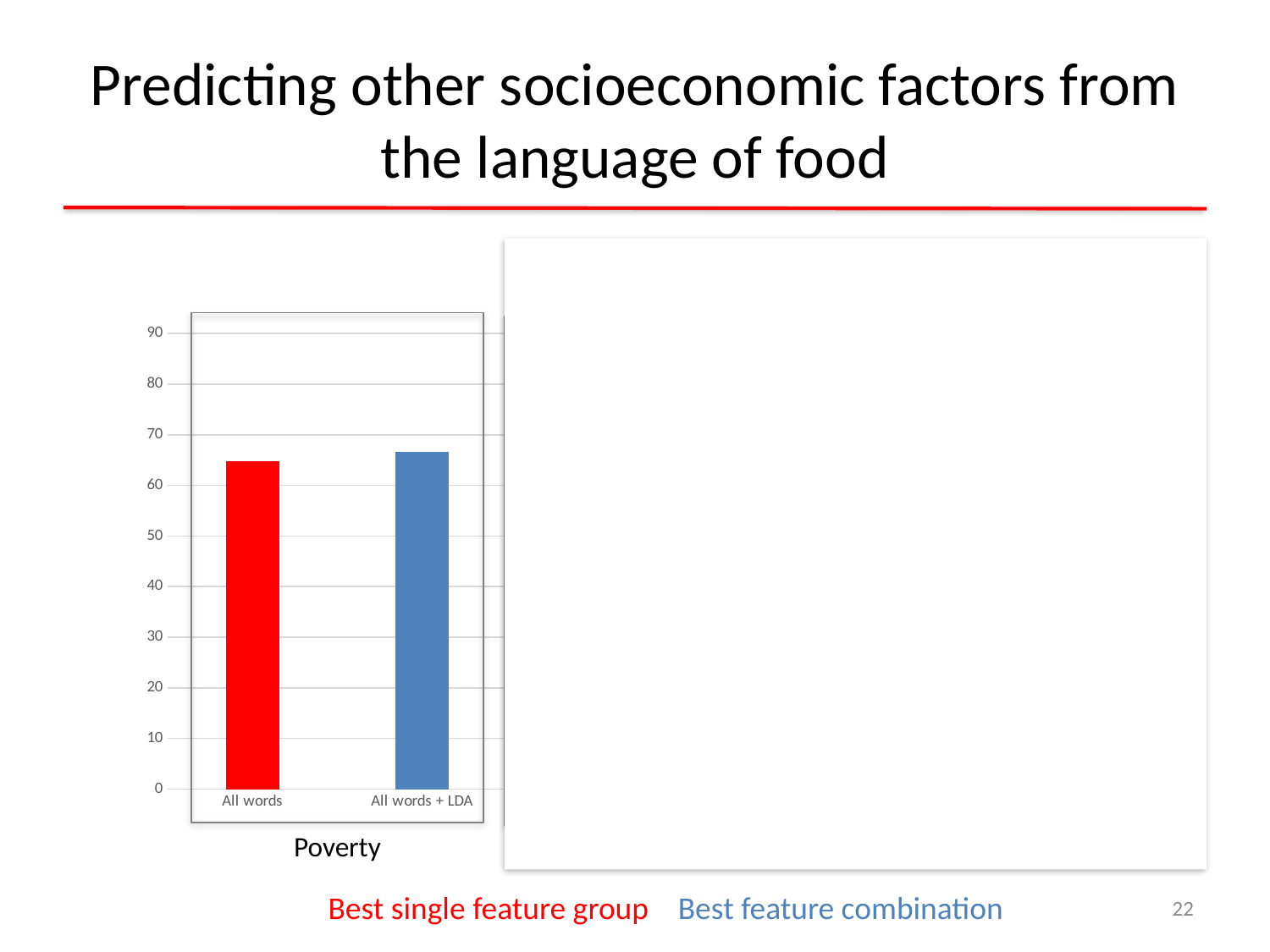
In the Poverty chart, is the value for All words greater or less than 70? less What kind of chart is shown on the slide? bar chart What are the two category labels on the x axis of the Poverty chart? All words, All words + LDA In the Poverty chart, is the value for All words greater or less than 60? greater How many bars are plotted in the Poverty chart? 2 What label appears beneath the chart on the slide? Poverty In the Poverty chart, is the value for All words greater or less than 50? greater What is the highest tick value shown on the y axis of the Poverty chart? 90